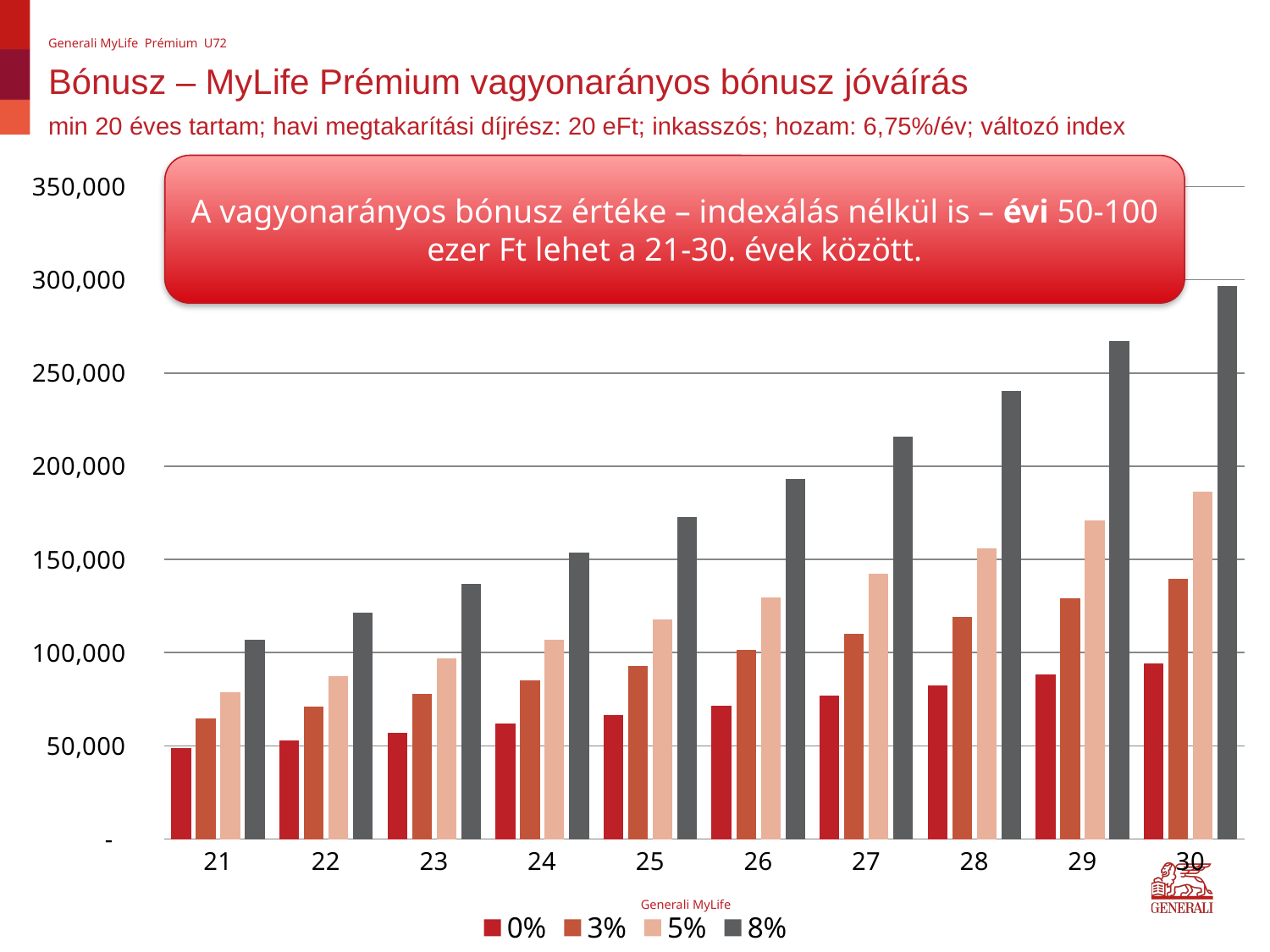
What kind of chart is shown on the slide? bar chart Which year has the lowest 0% bar? 21 Do the values of the 8% series rise or fall from year 21 to year 30? rise Which year has the highest 8% bar? 30 Is the value for the 8% series in year 29 greater or less than 250,000? greater Which series does the chart's legend list first? 0% Which is larger: the 8% value in year 21 or the 5% value in year 30? the 5% value in year 30 How many series does the chart's legend list? 4 Is the value for the 3% series in year 30 greater or less than 150,000? less Which series is drawn in dark grey in the chart? 8% How many year categories are shown on the x axis of the chart? 10 Is the value for the 5% series in year 30 greater or less than 200,000? less